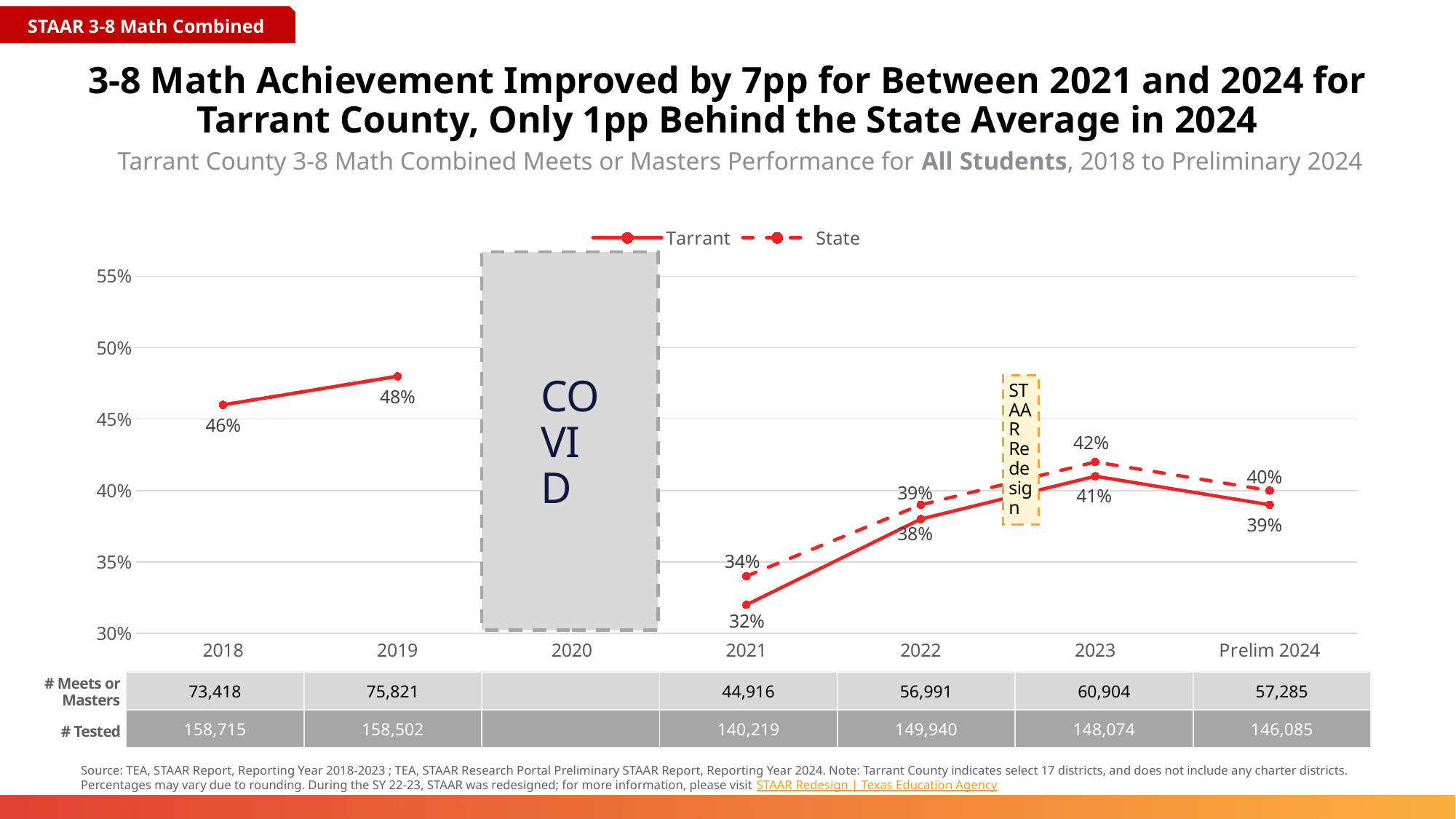
What is the Tarrant value for Prelim 2024? 39% What kind of chart is shown on the slide? Line chart In which year is the Tarrant line at its highest? 2019 What is the difference between the Tarrant values for 2023 and 2021? 9% What is the # Tested value shown for 2022? 149,940 What is the State value for 2023? 42% Which is larger in 2022, the Tarrant value or the State value? State Does the Tarrant line rise or fall from 2023 to Prelim 2024? Fall What is the Tarrant value for 2019? 48% How many series does the legend list? 2 What is the Tarrant value for 2021? 32% In which year is the Tarrant line at its lowest? 2021